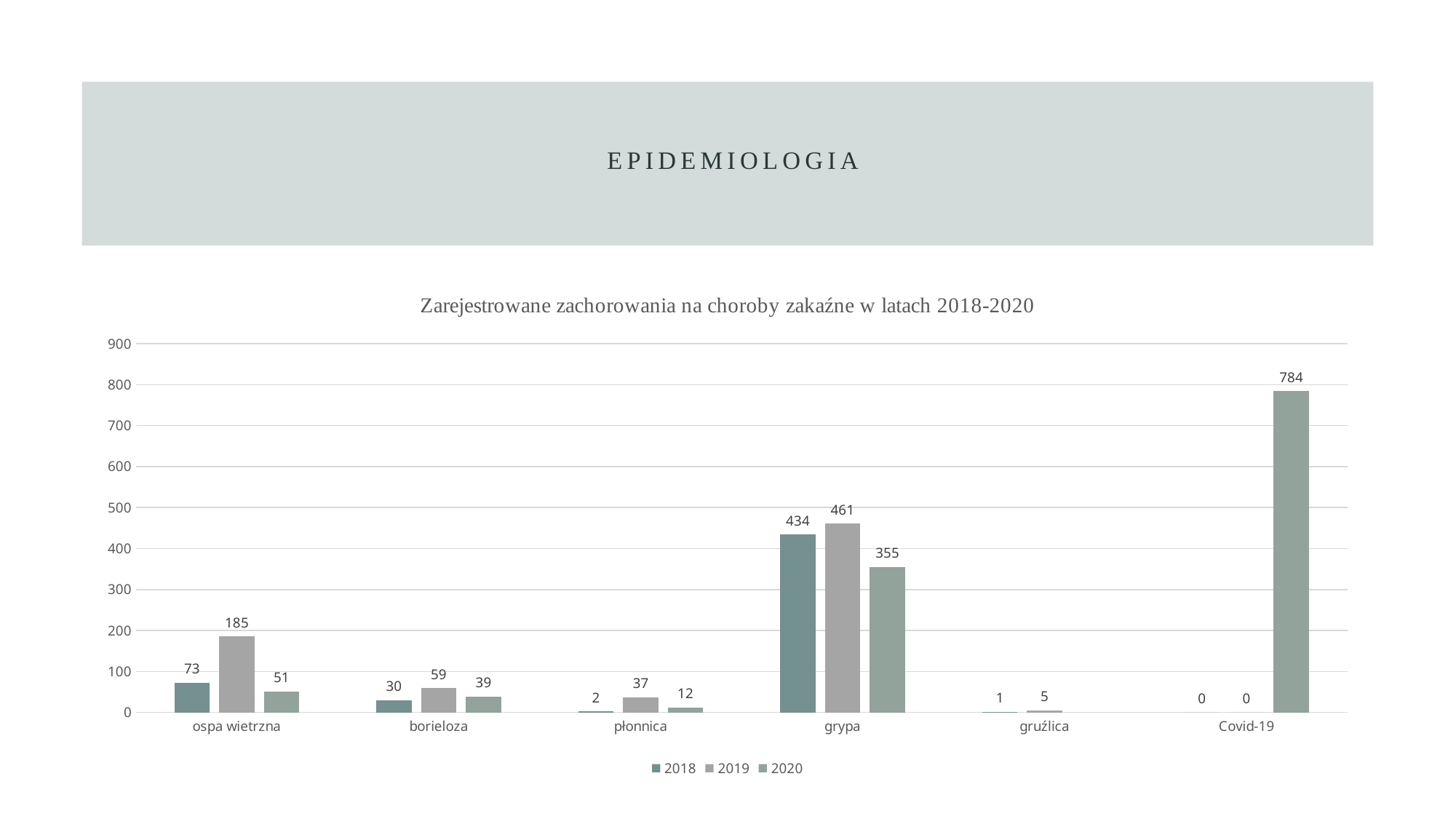
How many categories are shown on the x axis? 6 What is the value for ospa wietrzna in 2018? 73 What is the value for płonnica in 2019? 37 Which category has the lowest value in the 2019 series? Covid-19 Which is larger: the 2018 value for grypa or the 2020 value for grypa? 2018 value for grypa What kind of chart is shown on the slide? Bar chart What is the value for grypa in 2019? 461 What is the value for Covid-19 in 2020? 784 What is the difference between the 2019 and 2018 values for ospa wietrzna? 112 What is the title of the chart? Zarejestrowane zachorowania na choroby zakaźne w latach 2018-2020 Which category has the highest value in the 2020 series? Covid-19 How many series does the legend list? 3